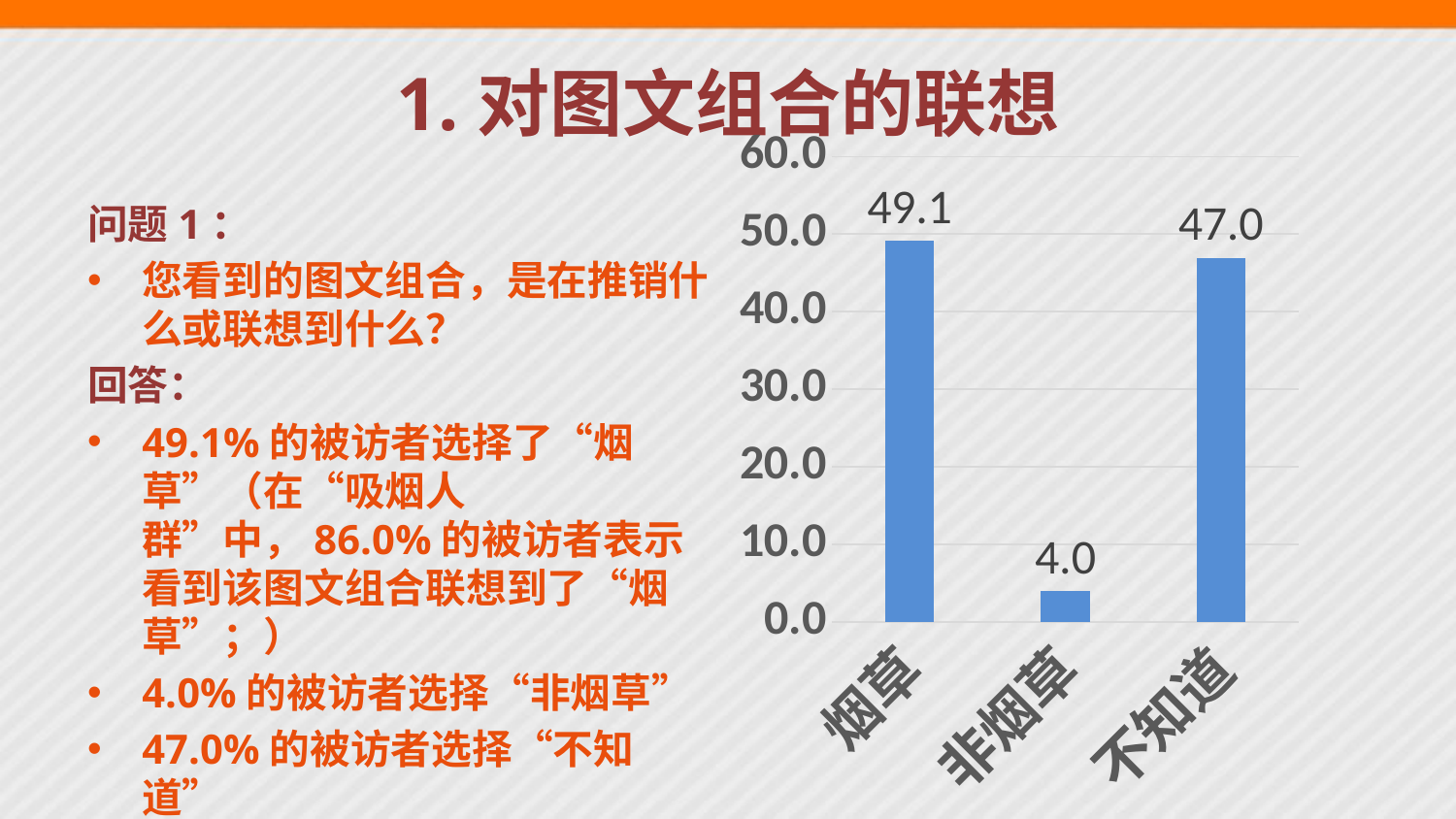
What is the value for 烟草? 49.1 Which is larger, the value for 烟草 or the value for 非烟草? 烟草 Which category has the lowest value? 非烟草 Which category has the highest value? 烟草 What is the difference between the values for 烟草 and 不知道? 2.1 What is the value for 非烟草? 4.0 How many categories are shown in the chart? 3 What kind of chart is shown on the slide? bar chart What is the difference between the values for 不知道 and 非烟草? 43.0 What is the value for 不知道? 47.0 Is the value for 不知道 greater or less than 40.0? greater What is the highest value shown on the vertical axis? 60.0